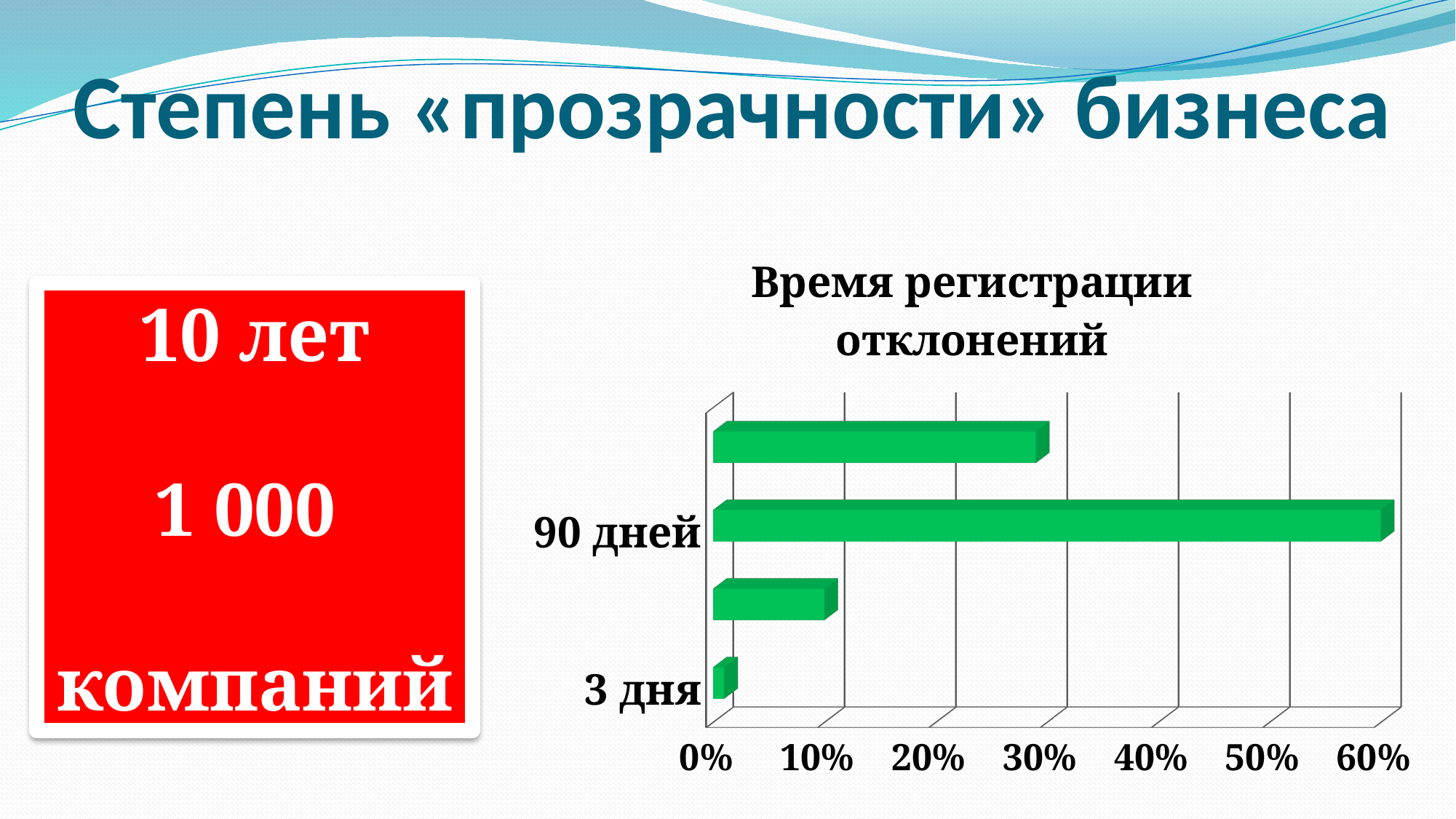
Which is larger, the value for "90 дней" or the value for "3 дня"? 90 дней Which labelled category has the longest bar in the chart? 90 дней How many bars are plotted in the chart? 4 Is the value for "90 дней" greater or less than 50%? greater Which labelled category has the shortest bar in the chart? 3 дня Is the value for "90 дней" greater or less than 40%? greater What kind of chart is shown under the title "Время регистрации отклонений"? bar chart Is the value for "3 дня" greater or less than 10%? less What is the title of the chart on the slide? Время регистрации отклонений What is the highest tick label shown on the horizontal axis of the chart? 60%